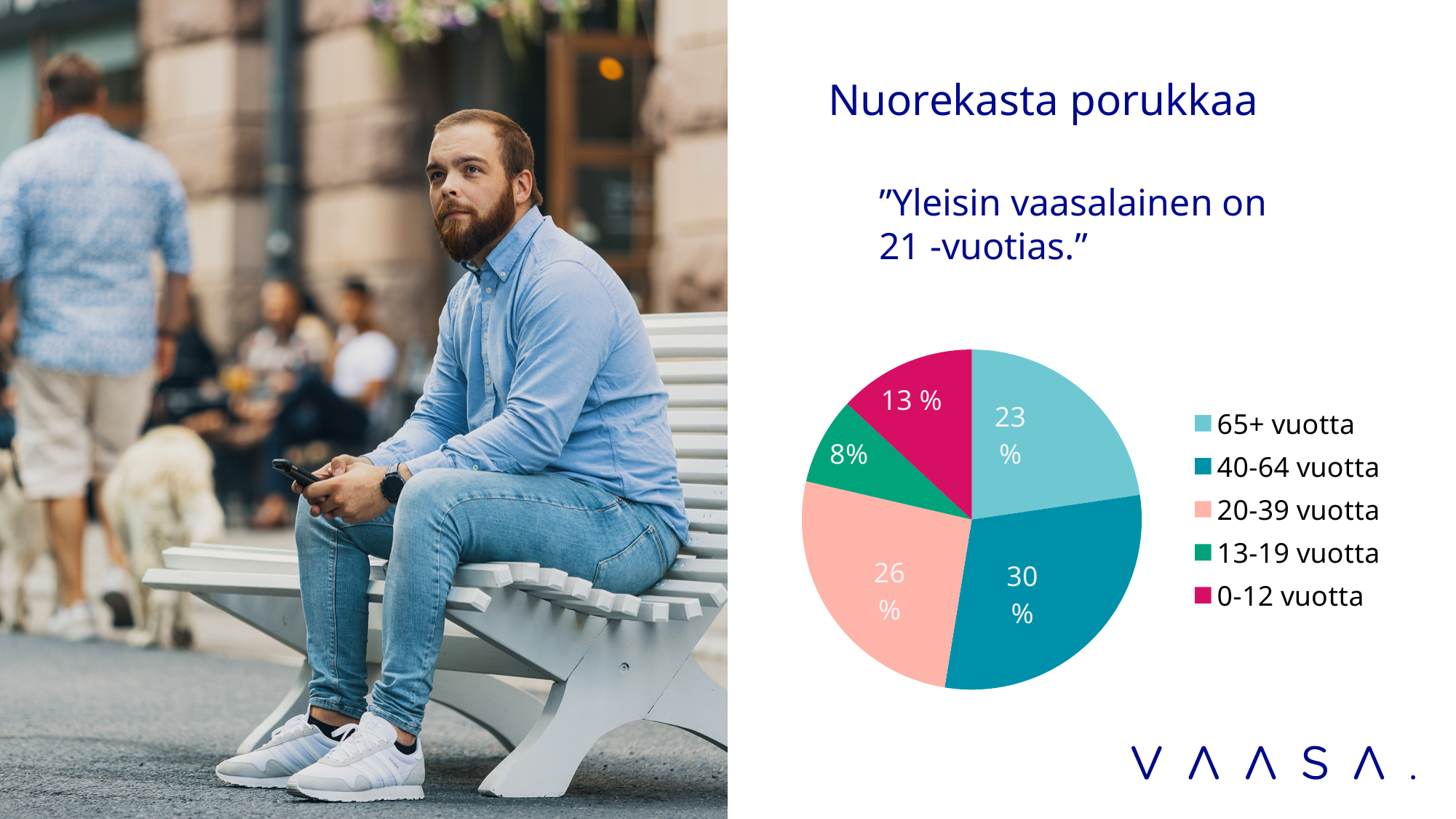
What is the value shown for 13-19 vuotta? 8% What is the difference in percentage points between the 40-64 vuotta and 65+ vuotta slices? 7 What is the value shown for 20-39 vuotta? 26 % What is the value shown for 65+ vuotta? 23 % What is the value shown for 0-12 vuotta? 13 % What colour is the 0-12 vuotta slice in the pie chart? magenta How many age groups are shown in the pie chart? 5 What share of the pie does the 40-64 vuotta slice represent? 30 % Which slice is larger, 20-39 vuotta or 0-12 vuotta? 20-39 vuotta Which age group has the smallest slice of the pie? 13-19 vuotta What kind of chart is shown on the slide? pie chart Which age group has the largest slice of the pie? 40-64 vuotta